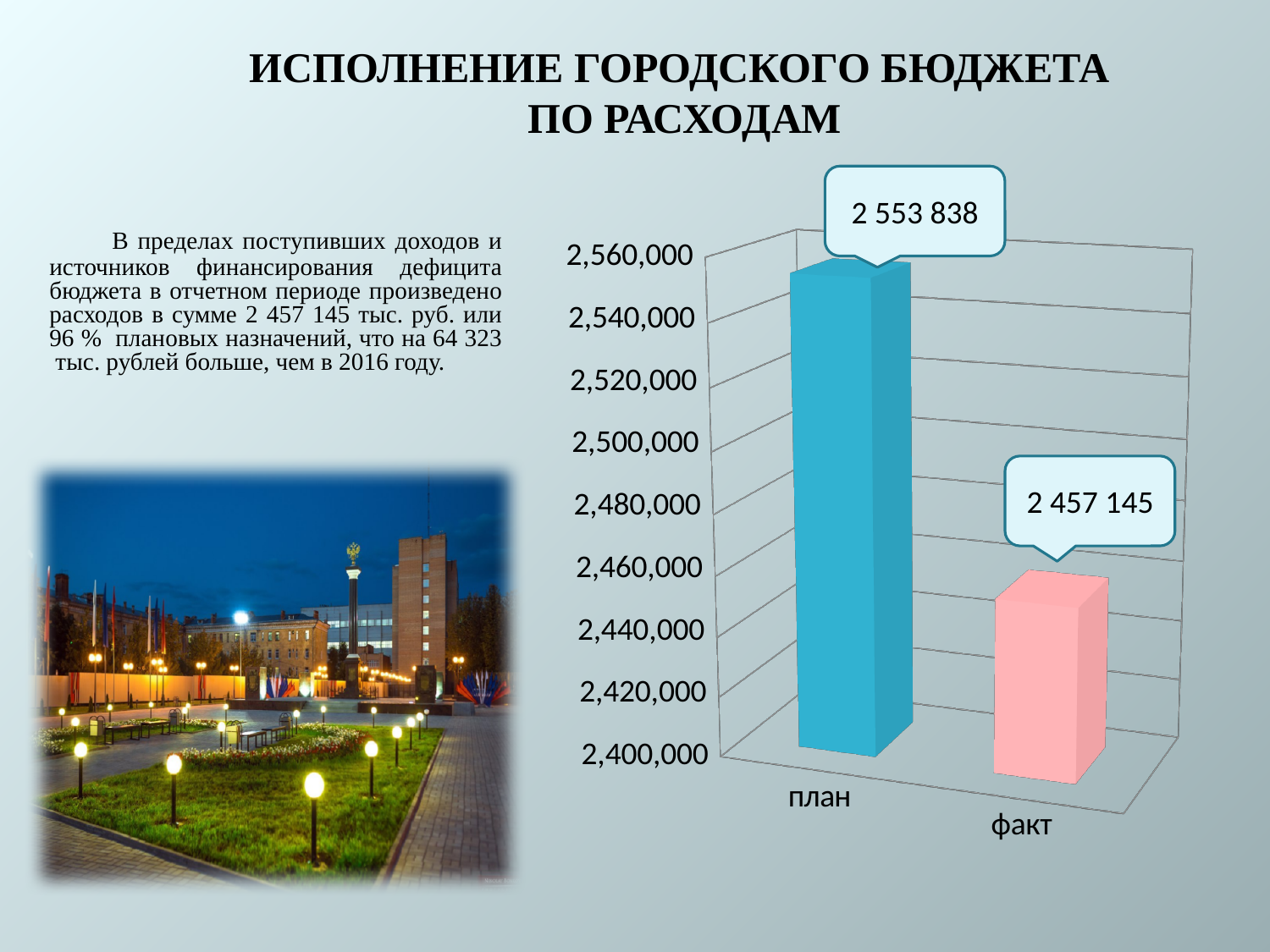
What is the value for факт? 2 457 145 Is the value for факт greater or less than 2,500,000? less What colour is the bar for факт? pink Which category has the higher value, план or факт? план What is the difference between the план and факт values? 96 693 Which category has the lowest value? факт What kind of chart is shown on the slide? bar chart What is the value for план? 2 553 838 How many categories are shown on the chart? 2 Which category has the highest value? план Do the values rise or fall from план to факт? fall Is the value for план greater or less than 2,540,000? greater